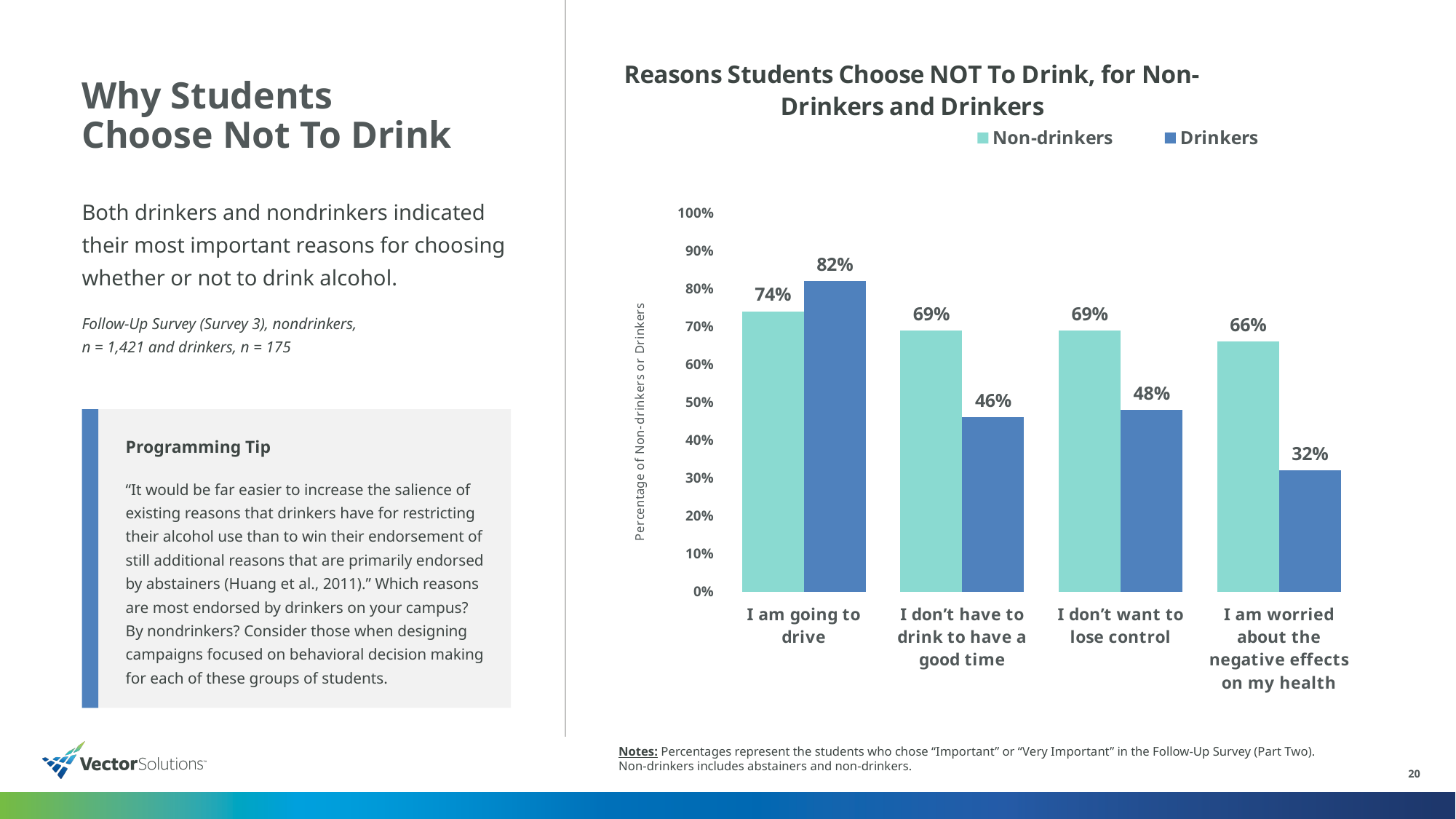
For "I am going to drive", which group has the larger value, Non-drinkers or Drinkers? Drinkers Which reason has the highest value for Drinkers? I am going to drive Is the Drinkers value for "I don't have to drink to have a good time" greater or less than 50%? less What is the value for Drinkers for "I don't want to lose control"? 48% Which reason has the lowest value for Non-drinkers? I am worried about the negative effects on my health How many series does the chart legend list? 2 What is the difference between the Non-drinkers and Drinkers values for "I don't have to drink to have a good time"? 23 percentage points What percentage of Drinkers chose "I am worried about the negative effects on my health"? 32% What is the title of the chart? Reasons Students Choose NOT To Drink, for Non-Drinkers and Drinkers How many reasons (categories) are shown on the x axis of the chart? 4 What kind of chart is shown on the slide? Bar chart What percentage of Non-drinkers chose "I am going to drive" as a reason not to drink? 74%